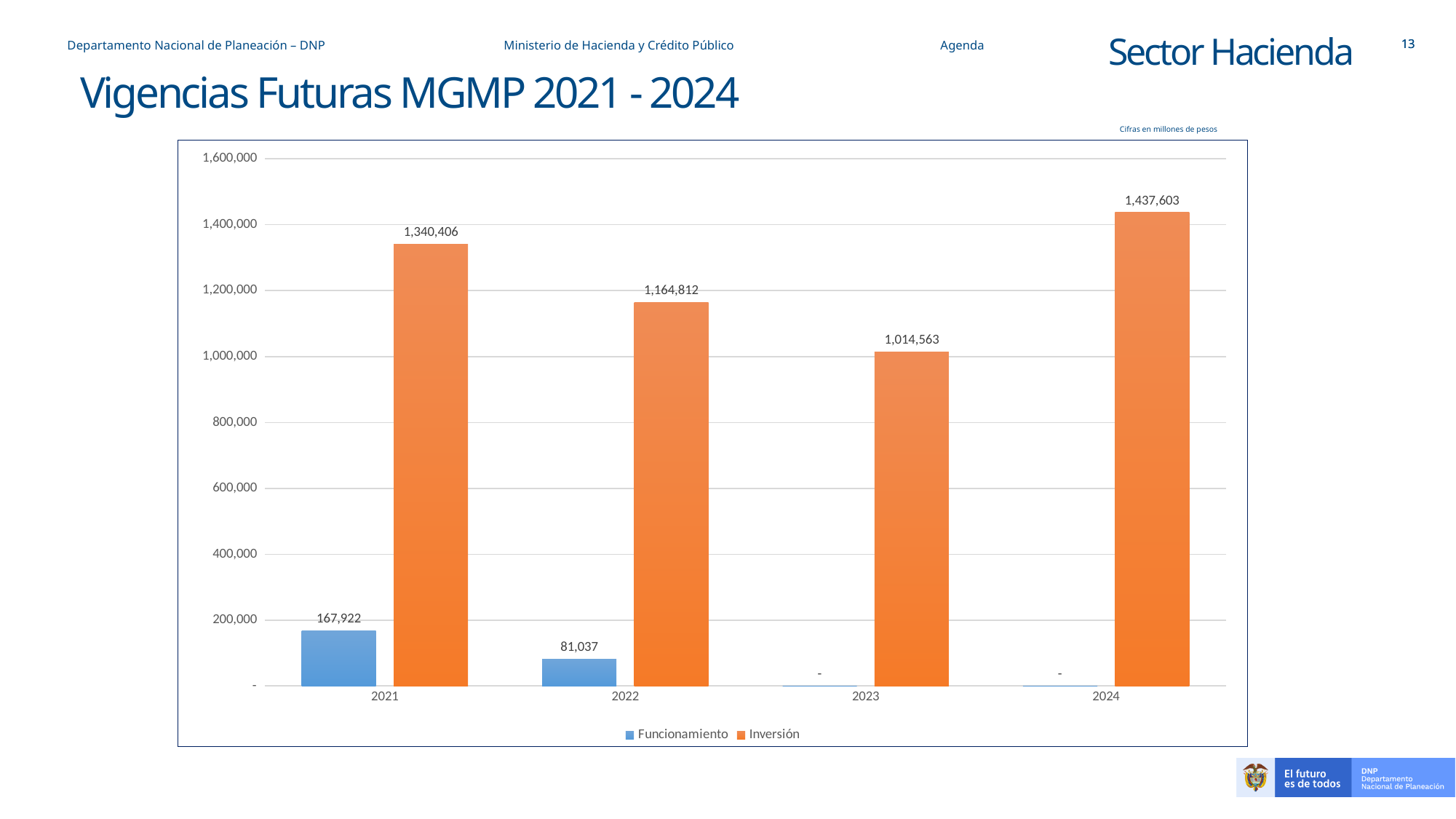
How many series does the legend list? 2 What is the Funcionamiento value for 2021? 167,922 What is the difference between the Inversión values for 2024 and 2023? 423,040 Which year has the highest Inversión value? 2024 What kind of chart is shown on the slide? Bar chart What is the difference between the Funcionamiento values for 2021 and 2022? 86,885 Which year has the lowest Inversión value? 2023 How many years are shown on the x axis? 4 What is the Inversión value for 2023? 1,014,563 Which is larger, the Inversión value for 2021 or for 2022? 2021 What is the Inversión value for 2021? 1,340,406 What is the Funcionamiento value for 2022? 81,037